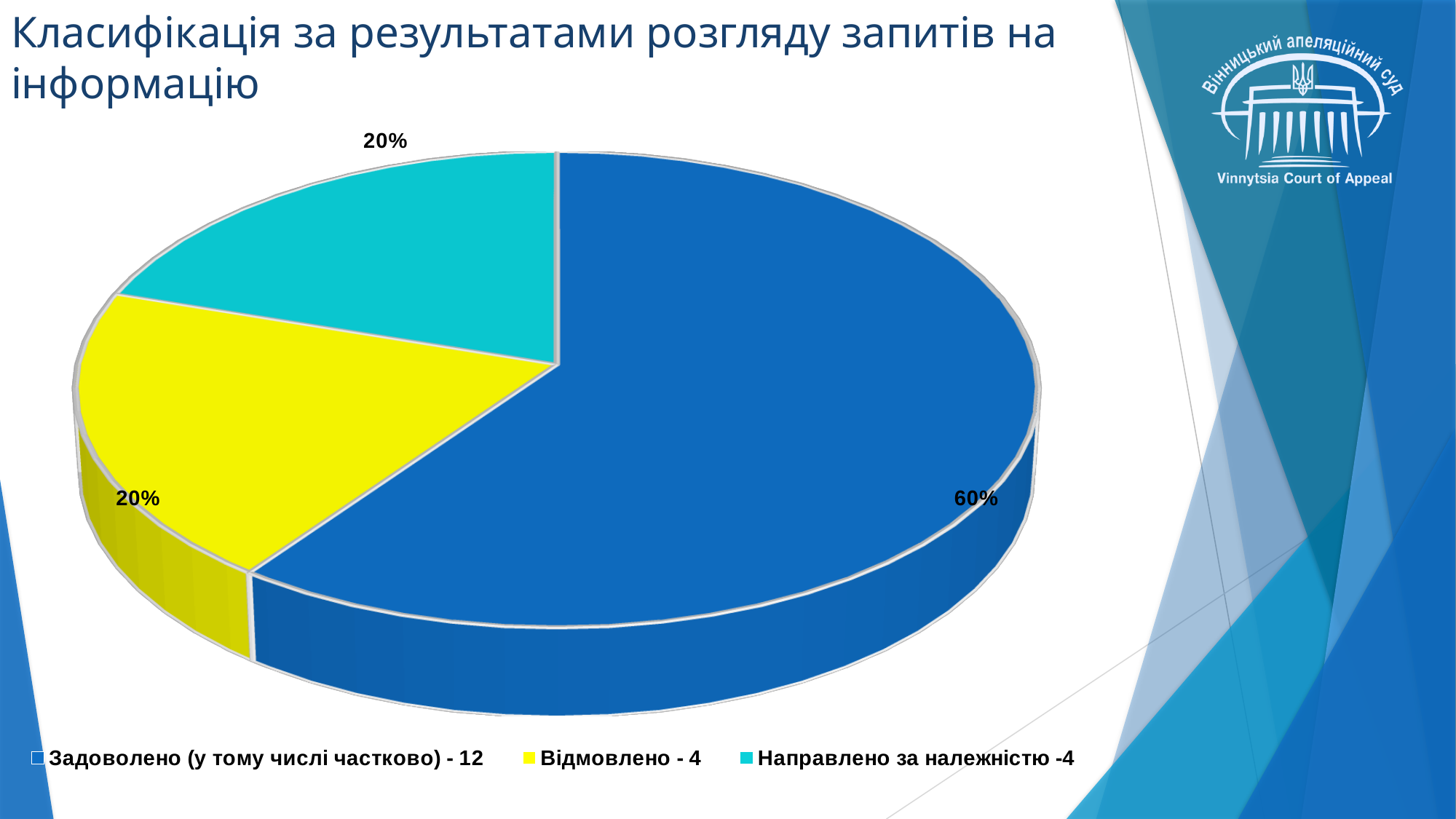
What colour is the slice for "Відмовлено"? Yellow Which category has the largest slice of the pie? Задоволено (у тому числі частково) What percentage share is shown for the slice "Відмовлено"? 20% Which is larger: the share for "Задоволено (у тому числі частково)" or the share for "Направлено за належністю"? Задоволено (у тому числі частково) What number is given in the legend for "Відмовлено"? 4 What percentage share is shown for the slice "Направлено за належністю"? 20% What kind of chart is shown on the slide? Pie chart What percentage share is shown for the slice "Задоволено (у тому числі частково)"? 60% What number is given in the legend for "Задоволено (у тому числі частково)"? 12 How many slices does the pie chart have? 3 What is the difference in percentage points between the "Задоволено (у тому числі частково)" slice and the "Відмовлено" slice? 40% What number is given in the legend for "Направлено за належністю"? 4